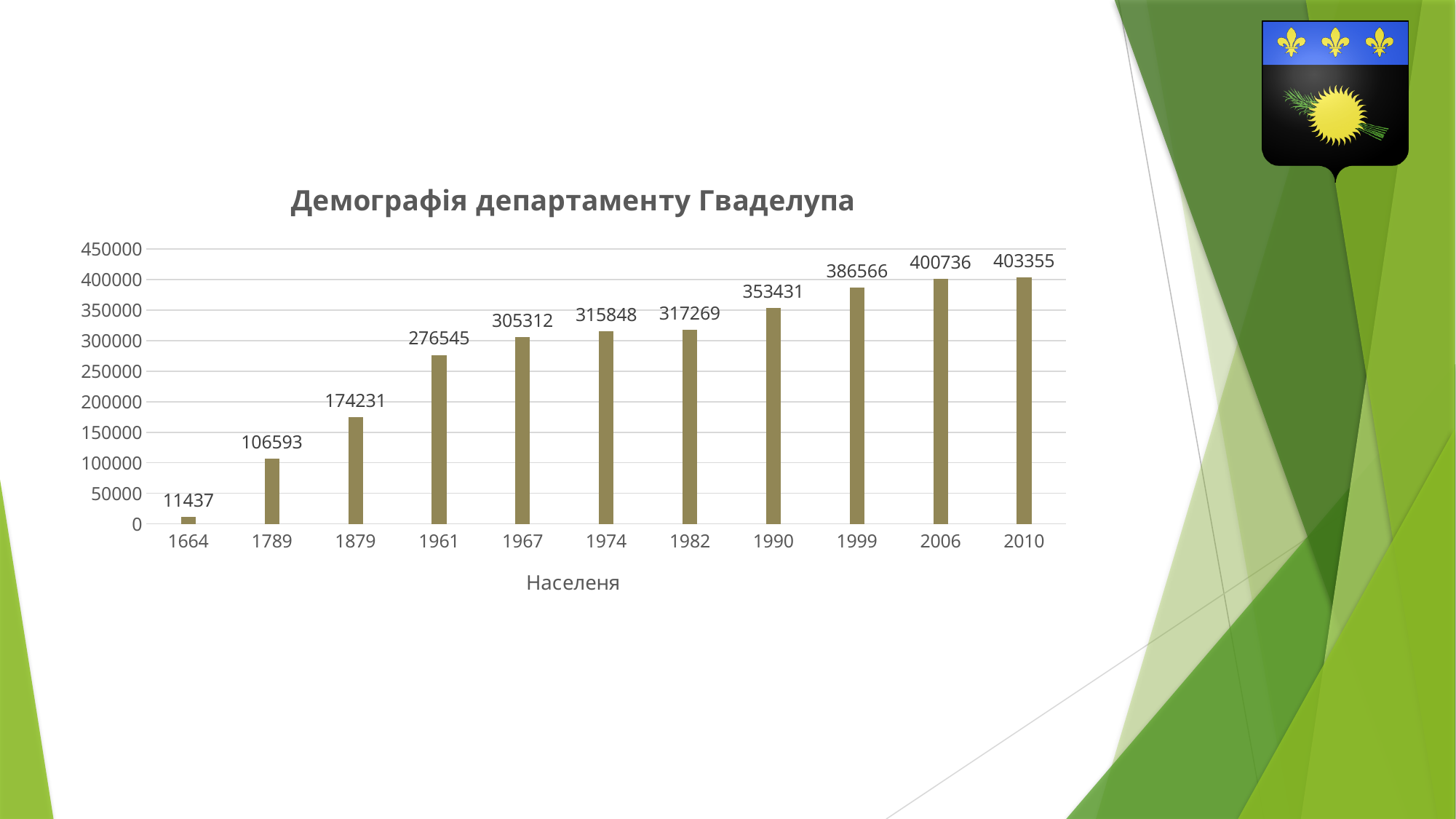
What is the population value shown for 1664? 11437 What is the difference between the population values for 2010 and 1664? 391918 Which year has the highest population value? 2010 What kind of chart is shown on the slide? bar chart What is the difference between the population values for 2006 and 1999? 14170 Which year has the lowest population value? 1664 Is the population value for 1789 greater or less than 150000? less What is the population value shown for 1961? 276545 Do the population values rise or fall from 1664 to 2010? rise What is the population value shown for 2010? 403355 Which year has a larger population value, 1879 or 1990? 1990 How many years are shown on the x axis? 11